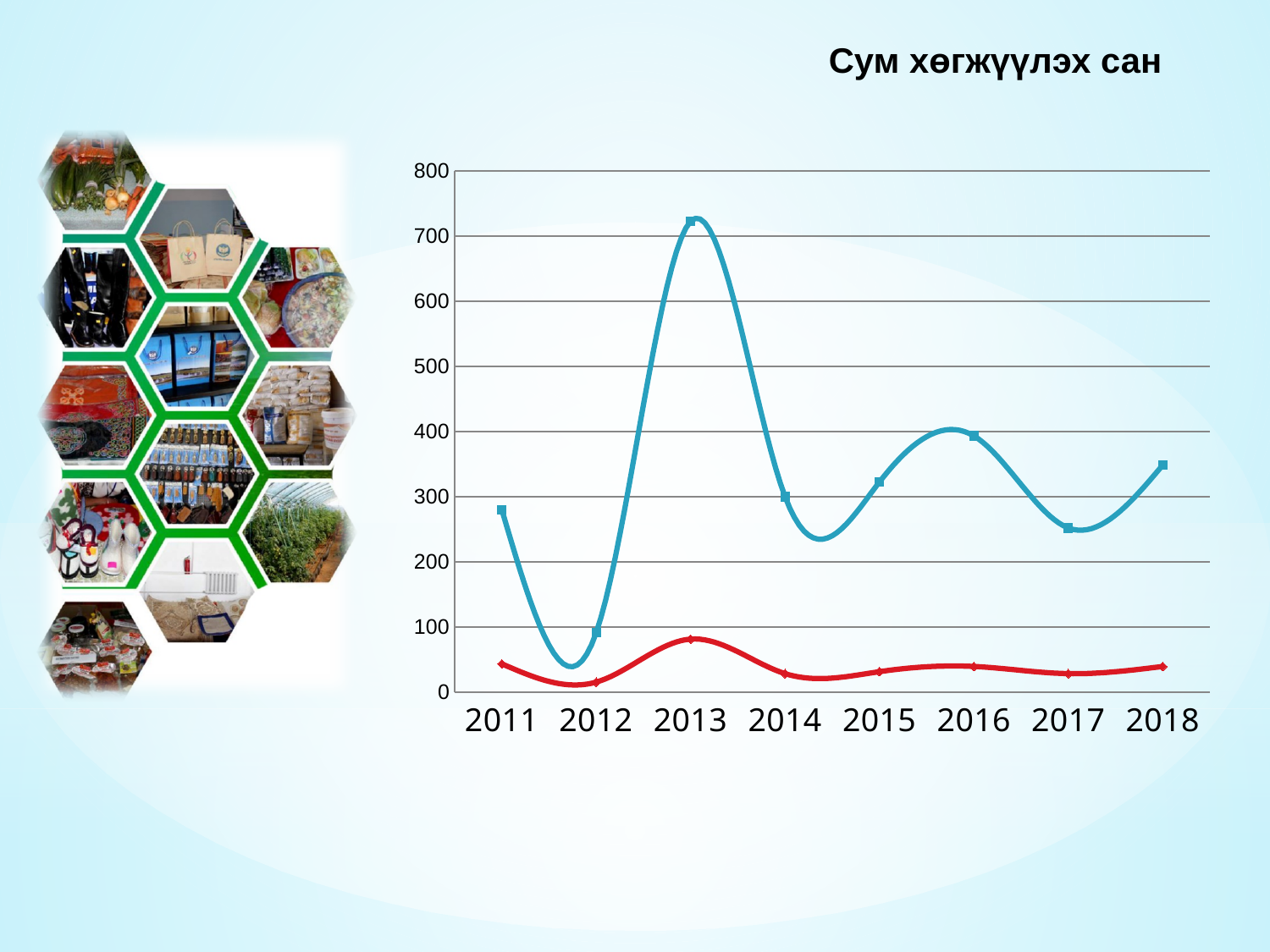
Does the blue line rise or fall from 2011 to 2012? fall What is the title of the chart on the slide? Сум хөгжүүлэх сан Is the value of the red line in 2013 greater or less than 100? less In which year does the blue line reach its highest value? 2013 What kind of chart is shown on the slide? line chart Is the value of the blue line in 2016 greater or less than 300? greater How many years are shown along the x axis of the chart? 8 Which line has the higher value in 2015, the blue line or the red line? the blue line Is the value of the blue line in 2013 greater or less than 700? greater In which year does the blue line reach its lowest value? 2012 How many lines are plotted on the chart? 2